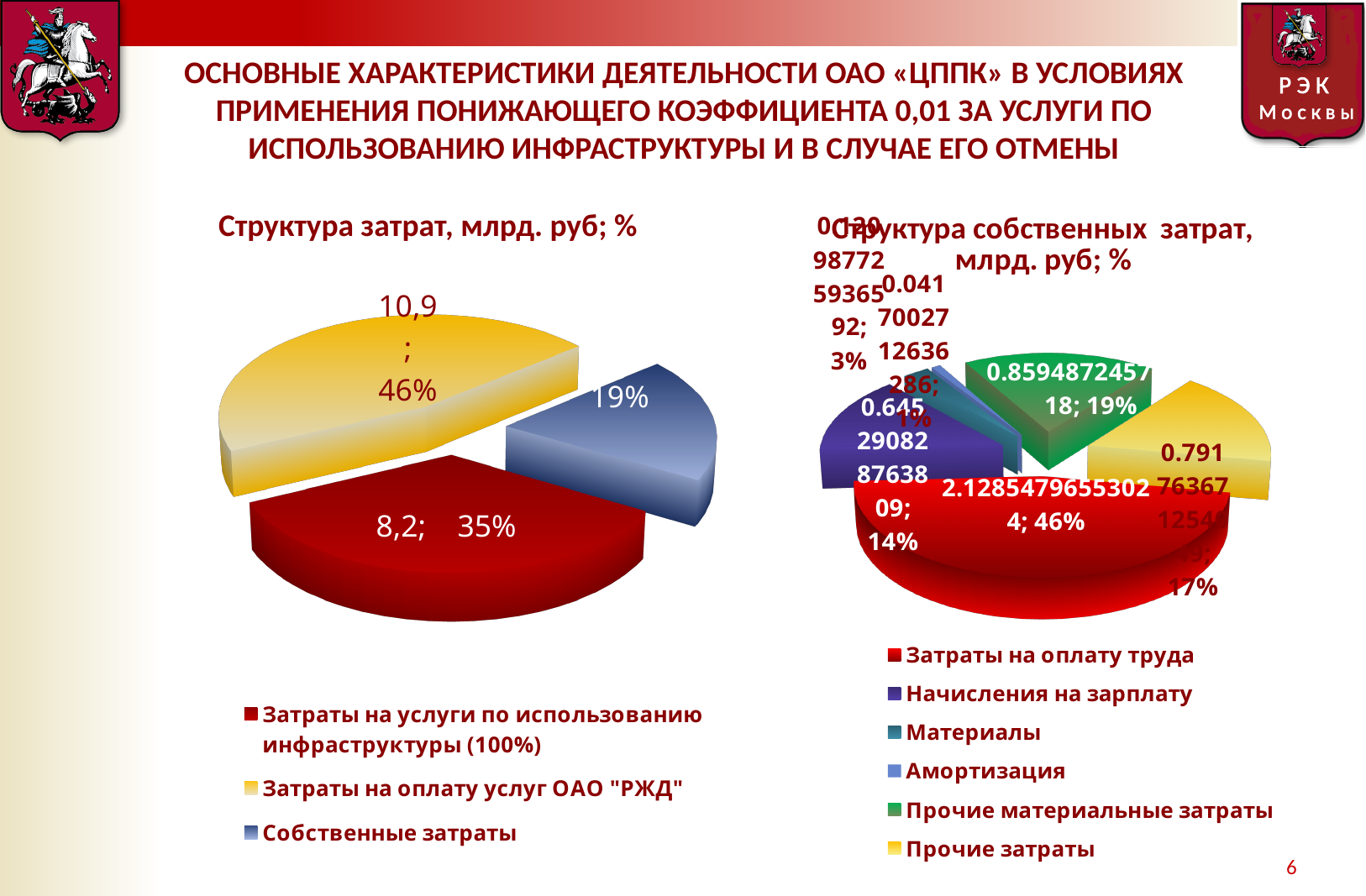
In the left chart "Структура затрат, млрд. руб; %", which category has the largest slice? Затраты на оплату услуг ОАО "РЖД" In the right chart "Структура собственных затрат, млрд. руб; %", what share does "Затраты на оплату труда" have? 46% In the right chart "Структура собственных затрат, млрд. руб; %", what share does "Прочие материальные затраты" have? 19% In the left chart "Структура затрат, млрд. руб; %", what is the value in млрд. руб for "Затраты на услуги по использованию инфраструктуры (100%)"? 8,2 What kind of chart is the left chart titled "Структура затрат, млрд. руб; %"? Pie chart In the left chart "Структура затрат, млрд. руб; %", what share does "Затраты на оплату услуг ОАО "РЖД"" have? 46% In the left chart "Структура затрат, млрд. руб; %", what is the difference in млрд. руб between "Затраты на оплату услуг ОАО "РЖД"" and "Затраты на услуги по использованию инфраструктуры (100%)"? 2,7 In the right chart "Структура собственных затрат, млрд. руб; %", which category has the smallest slice? Амортизация How many entries does the legend of the left chart "Структура затрат, млрд. руб; %" list? 3 How many entries does the legend of the right chart "Структура собственных затрат, млрд. руб; %" list? 6 In the left chart "Структура затрат, млрд. руб; %", which category has the smallest slice? Собственные затраты